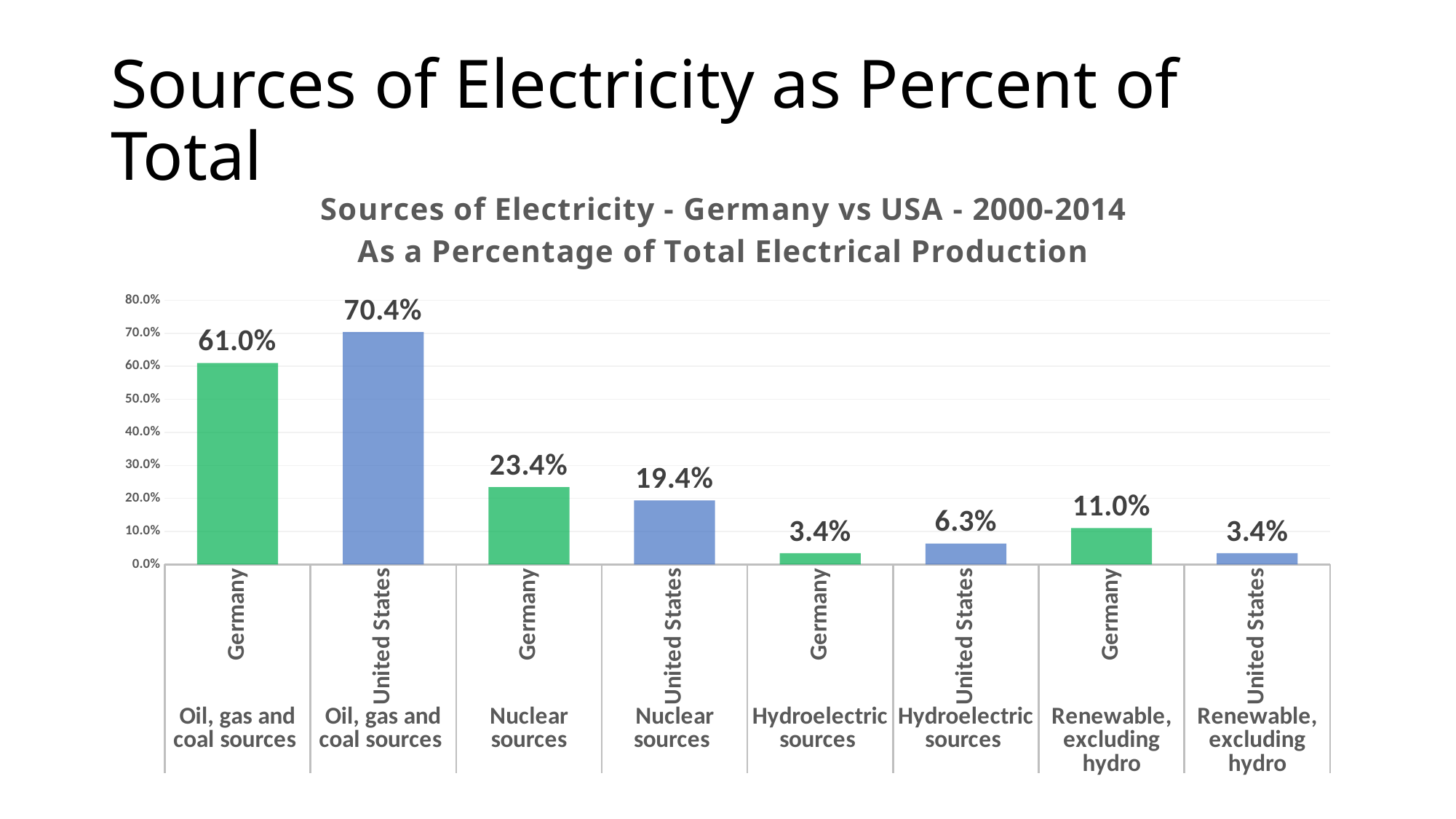
What colour are the bars for Germany? Green How many bars are plotted on the chart? 8 What kind of chart is shown on the slide? Bar chart Which is larger: Germany's hydroelectric sources value or the United States' hydroelectric sources value? United States Is the value for Germany's nuclear sources greater or less than 20.0%? greater What is the difference between Germany's and the United States' nuclear sources values? 4.0% What is the difference between the United States and Germany values for oil, gas and coal sources? 9.4% What percentage of United States electricity comes from nuclear sources? 19.4% What is the title of the chart? Sources of Electricity - Germany vs USA - 2000-2014 As a Percentage of Total Electrical Production Which bar has the highest value on the chart? United States, Oil, gas and coal sources What percentage of Germany's electricity comes from oil, gas and coal sources? 61.0% What is the value for Germany's renewable, excluding hydro, sources? 11.0%